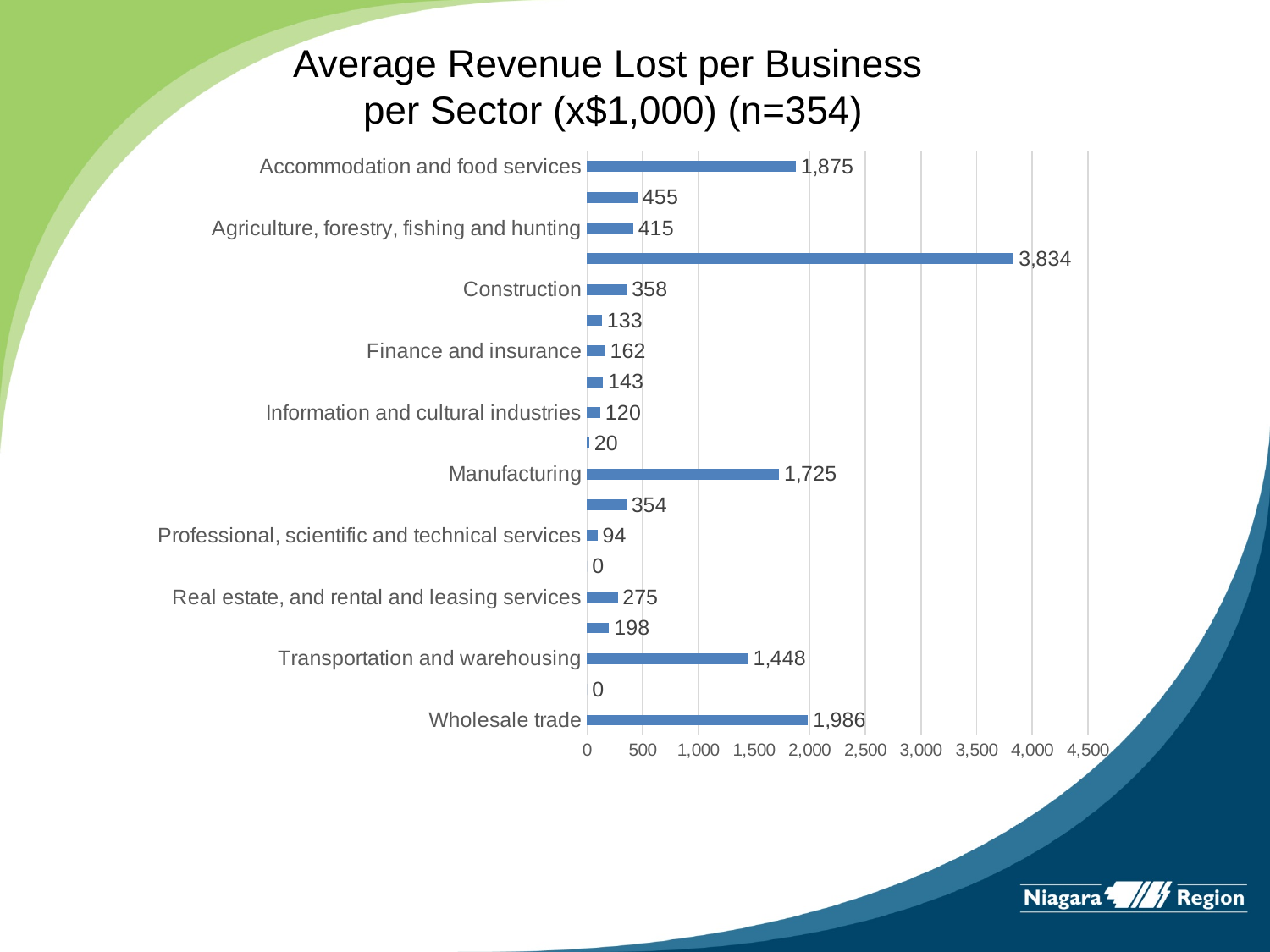
What is the largest value labelled on any bar in the chart? 3,834 What is the average revenue lost per business for Accommodation and food services? 1,875 What value is shown for Professional, scientific and technical services? 94 What is the title of the chart? Average Revenue Lost per Business per Sector (x$1,000) (n=354) What type of chart is shown on the slide? Bar chart What value is shown for Wholesale trade? 1,986 Which is larger, the value for Wholesale trade or the value for Accommodation and food services? Wholesale trade What is the value for Real estate, and rental and leasing services? 275 Is the value for Transportation and warehousing greater or less than 1,000? greater What is the difference between the values for Manufacturing and Transportation and warehousing? 277 What is the value for Manufacturing? 1,725 What is the difference between the values for Construction and Real estate, and rental and leasing services? 83